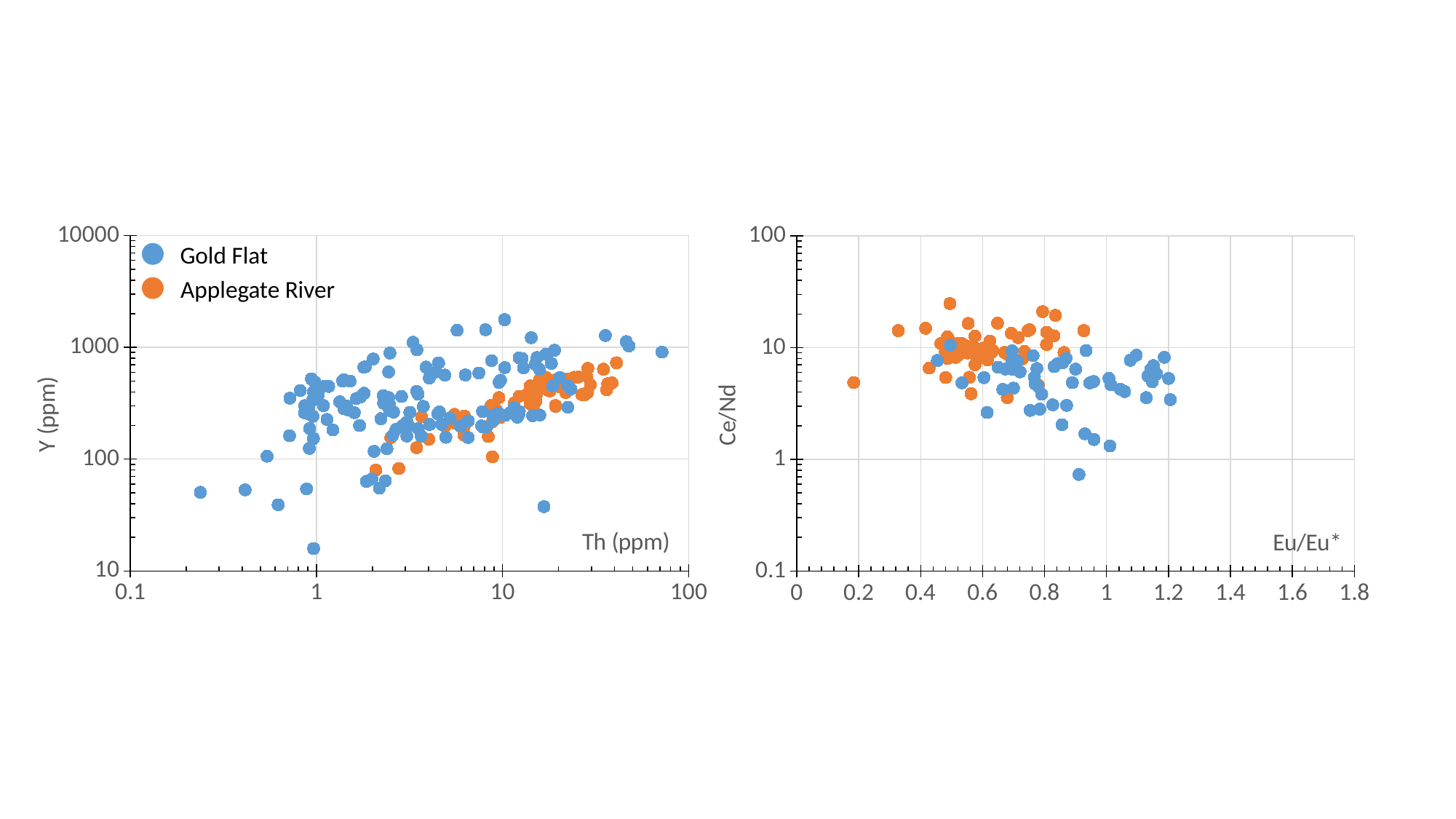
On the left chart, what are the two series named in the legend? Gold Flat and Applegate River On the left chart, do Y (ppm) values generally rise or fall as Th (ppm) increases? rise What kind of chart is the right chart (Ce/Nd vs Eu/Eu*)? scatter chart On the left chart, is the Y (ppm) value of the rightmost Gold Flat point (near Th = 70) greater or less than 100? greater How many series does the legend on the left chart list? 2 On the right chart, is the Ce/Nd value of the highest Applegate River point (near Eu/Eu* = 0.5) greater or less than 10? greater On the right chart, is the Ce/Nd value of the leftmost Applegate River point (near Eu/Eu* = 0.2) greater or less than 10? less On the left chart, what is the label of the vertical axis? Y (ppm) On the right chart, do Ce/Nd values generally rise or fall as Eu/Eu* increases? fall What kind of chart is the left chart (Y (ppm) vs Th (ppm))? scatter chart